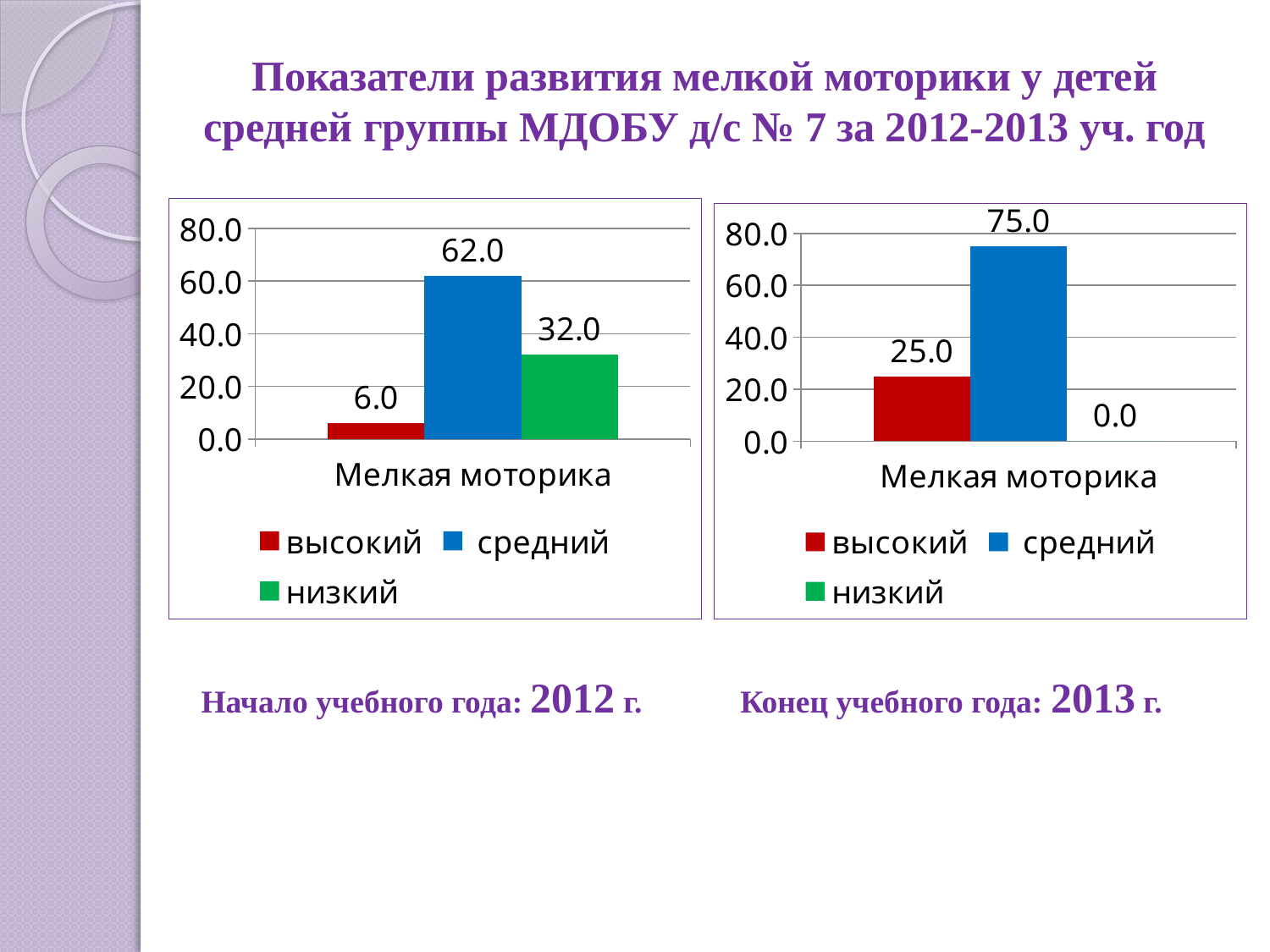
In the right chart (Конец учебного года: 2013 г.), which series has the highest value? средний In the left chart (Начало учебного года: 2012 г.), what is the value for низкий? 32.0 In the right chart (Конец учебного года: 2013 г.), what is the value for высокий? 25.0 In the left chart (Начало учебного года: 2012 г.), what colour is the bar for средний? blue In the left chart (Начало учебного года: 2012 г.), what is the value for средний? 62.0 In the left chart (Начало учебного года: 2012 г.), which series has the lowest value? высокий How many series does the legend of the left chart (Начало учебного года: 2012 г.) list? 3 Which is larger: the value for высокий in the left chart (2012) or the value for высокий in the right chart (2013)? the right chart (2013) What kind of chart is the right chart (Конец учебного года: 2013 г.)? bar chart In the right chart (Конец учебного года: 2013 г.), what is the difference between the values for средний and высокий? 50.0 In the left chart (Начало учебного года: 2012 г.), what is the difference between the values for средний and низкий? 30.0 In the right chart (Конец учебного года: 2013 г.), what is the value for низкий? 0.0